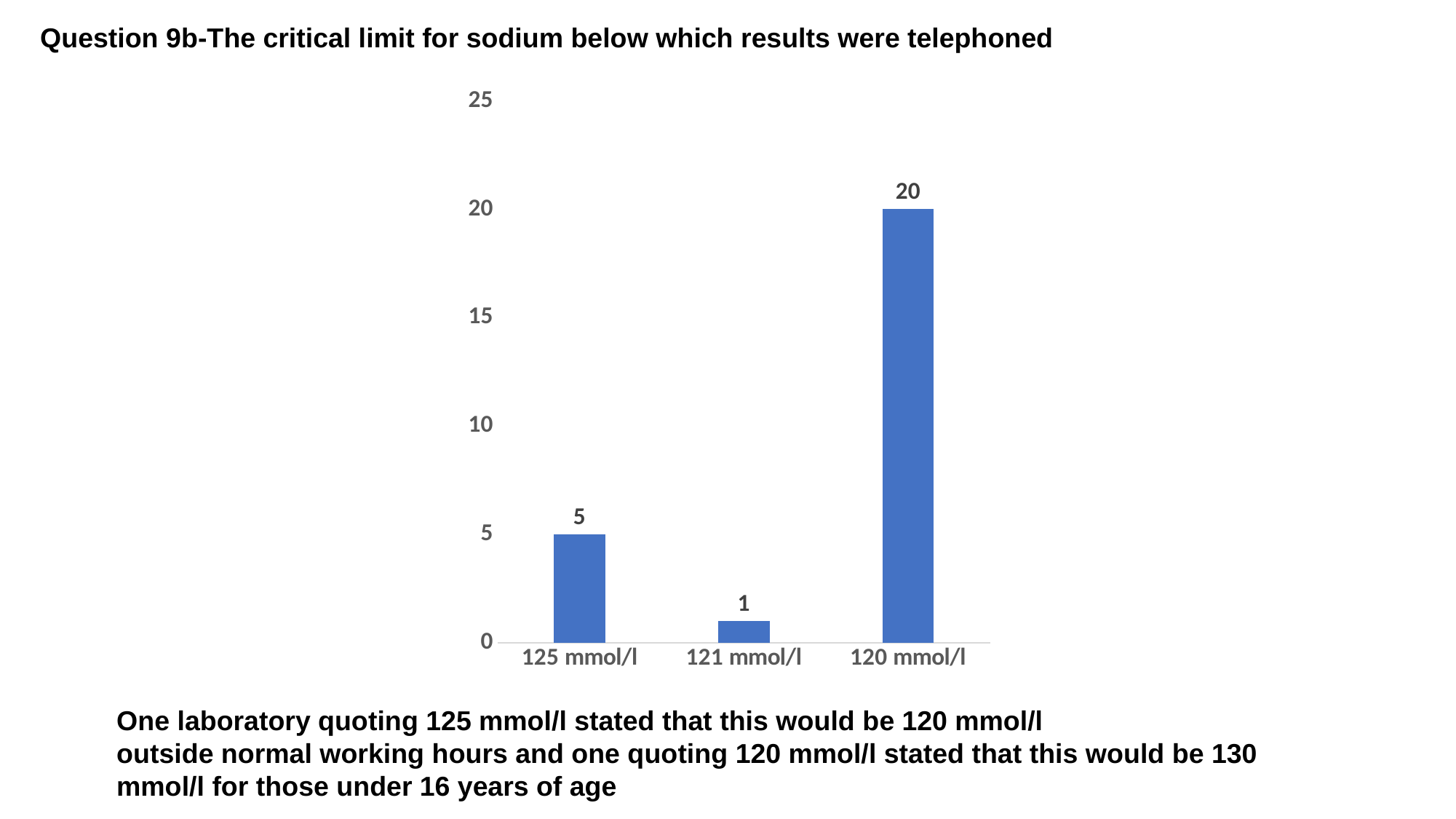
What is the value for 121 mmol/l? 1 Which category has the highest value? 120 mmol/l What is the difference between the values for 125 mmol/l and 121 mmol/l? 4 Which is larger, the value for 125 mmol/l or the value for 121 mmol/l? 125 mmol/l What is the difference between the values for 120 mmol/l and 125 mmol/l? 15 Which category has the lowest value? 121 mmol/l What is the title of the chart? Question 9b-The critical limit for sodium below which results were telephoned How many categories are shown on the x axis? 3 What kind of chart is shown on the slide? bar chart What is the value for 120 mmol/l? 20 What is the value for 125 mmol/l? 5 Is the value for 120 mmol/l greater or less than 15? greater